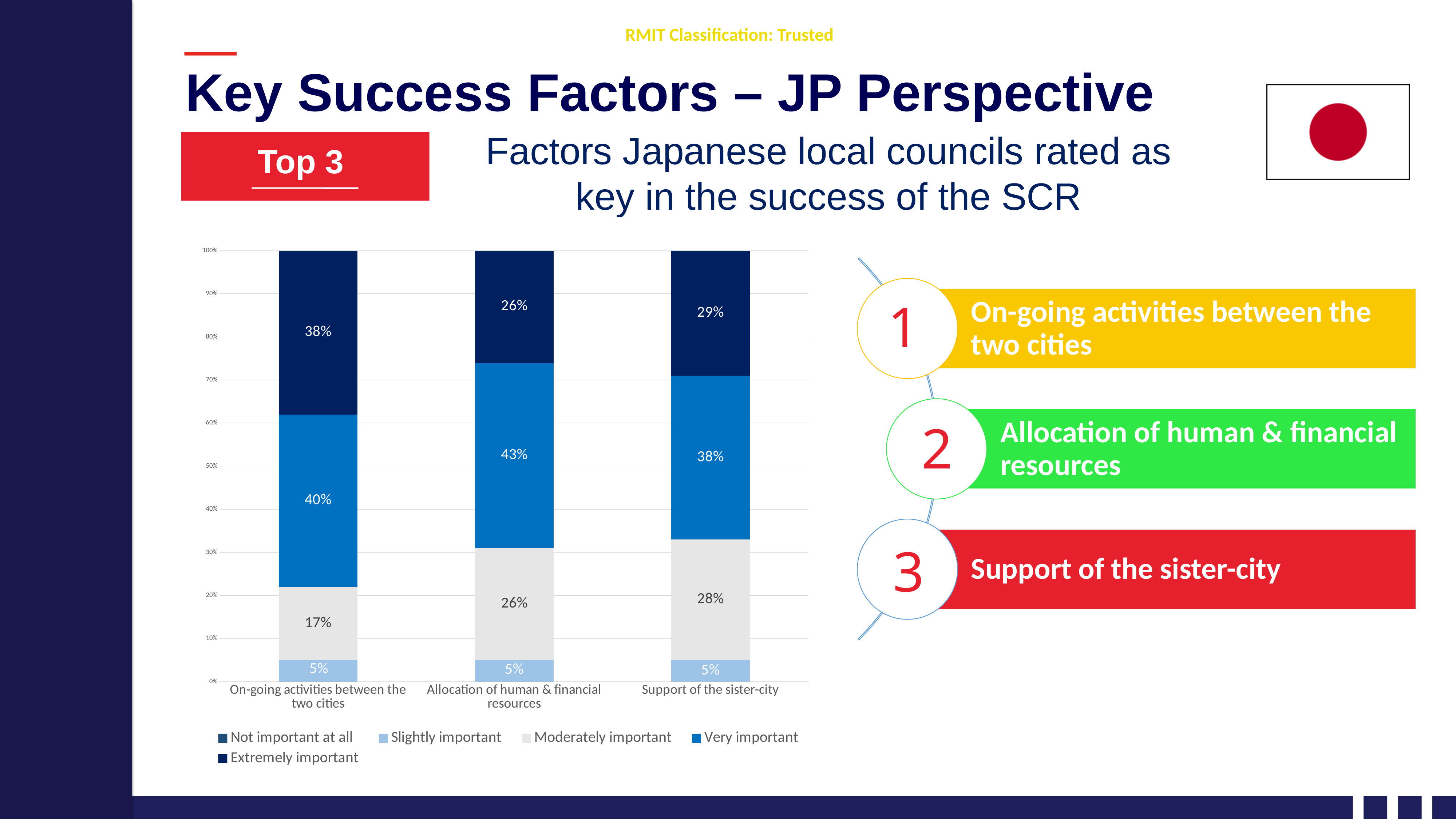
How many series does the chart's legend list? 5 What is the 'Slightly important' value for 'Allocation of human & financial resources'? 5% What is the 'Extremely important' value for 'On-going activities between the two cities'? 38% Which category has the lowest 'Moderately important' value? On-going activities between the two cities Which category has the highest 'Extremely important' value? On-going activities between the two cities What kind of chart is shown on the slide? stacked bar chart What is the 'Very important' value for 'Allocation of human & financial resources'? 43% Which is larger: the 'Extremely important' value for 'Support of the sister-city' or for 'Allocation of human & financial resources'? Support of the sister-city What is the 'Moderately important' value for 'Support of the sister-city'? 28% How many categories are shown on the x axis of the chart? 3 What is the difference between the 'Very important' values for 'Allocation of human & financial resources' and 'Support of the sister-city'? 5%